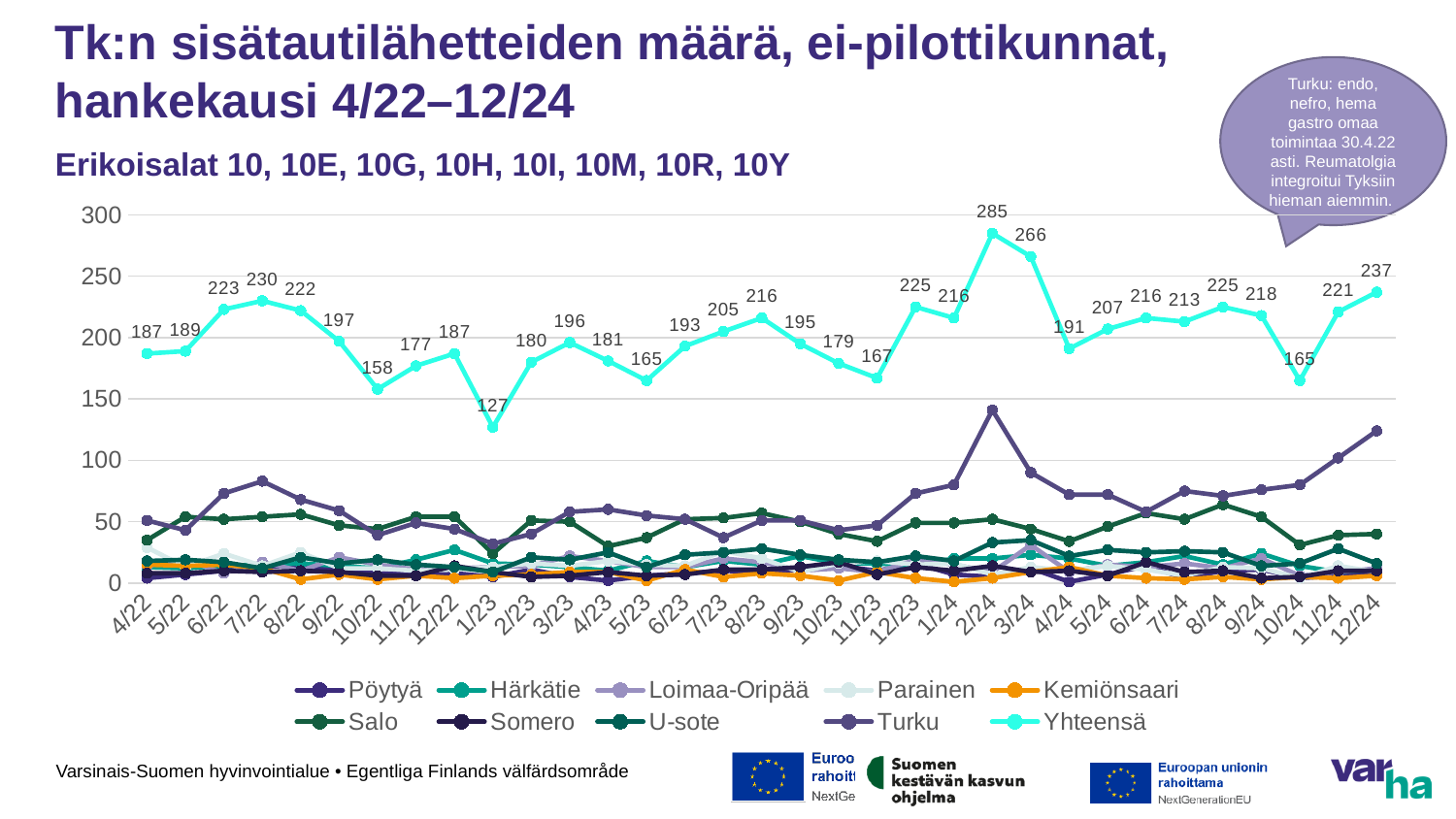
How many series does the legend list? 10 In which month does the Yhteensä series reach its lowest value? 1/23 What is the difference between the Yhteensä values in 2/24 and 3/24? 19 In which month does the Yhteensä series reach its highest value? 2/24 Which is larger for the Yhteensä series: the value in 7/22 or the value in 12/23? 7/22 Is the value for Turku in 2/24 greater or less than 150? less Does the Yhteensä series rise or fall from 9/24 to 10/24? fall How many months are plotted on the x axis? 33 What is the value of the Yhteensä series in 2/24? 285 What kind of chart is shown on the slide? line chart What is the value of the Yhteensä series in 1/23? 127 What is the value of the Yhteensä series in 12/24? 237